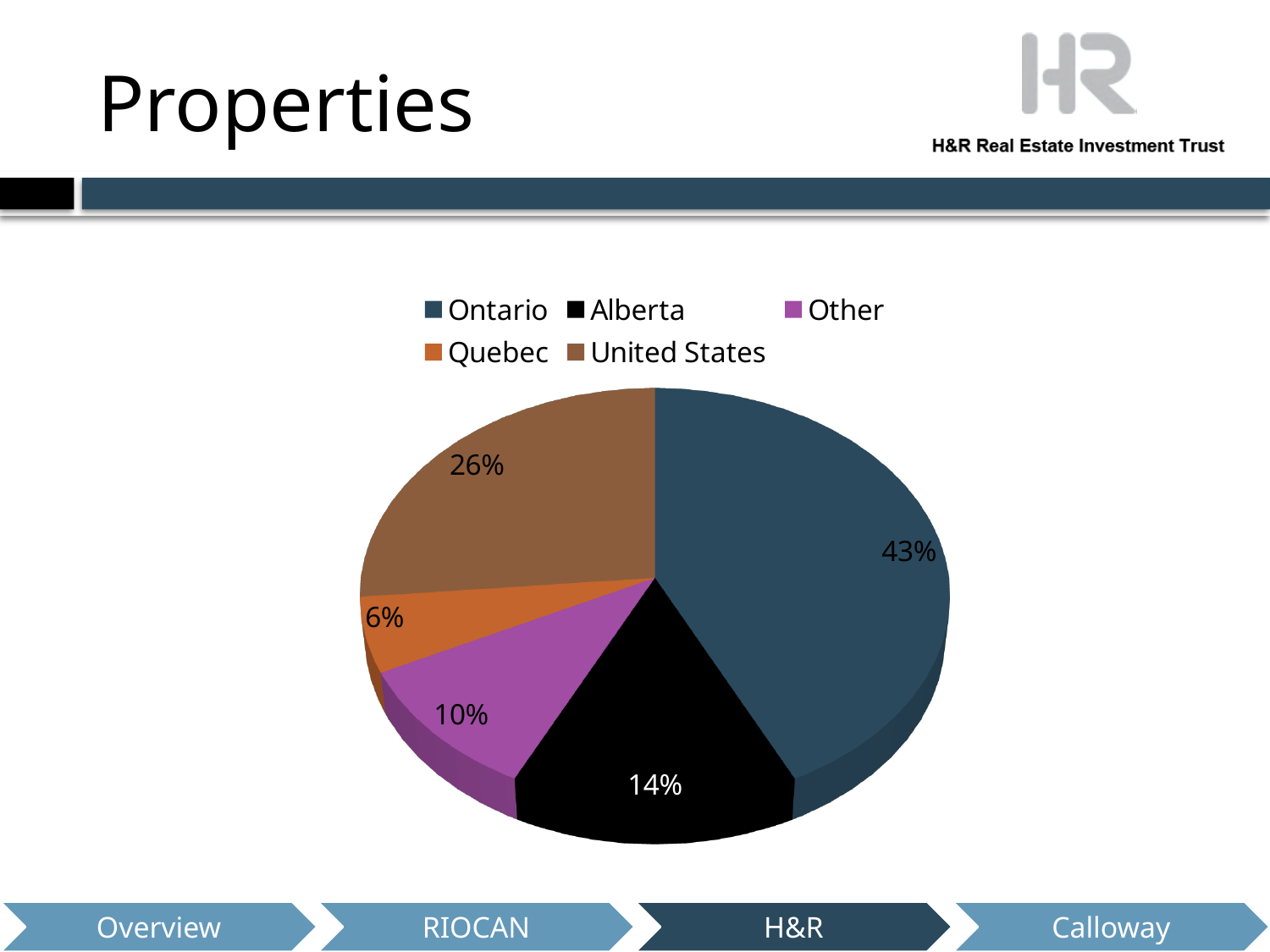
Which category has the largest slice of the pie? Ontario What share of the pie does the United States hold? 26% How many categories does the legend list? 5 What colour is the slice for Other? purple Which is larger, the slice for Alberta or the slice for Other? Alberta What is the difference in percentage points between Ontario and the United States? 17 What kind of chart is shown on the slide? pie chart What share of the pie does Alberta hold? 14% What share of the pie does Other hold? 10% Which category has the smallest slice of the pie? Quebec What share of the pie does Quebec hold? 6% What share of the pie does Ontario hold? 43%